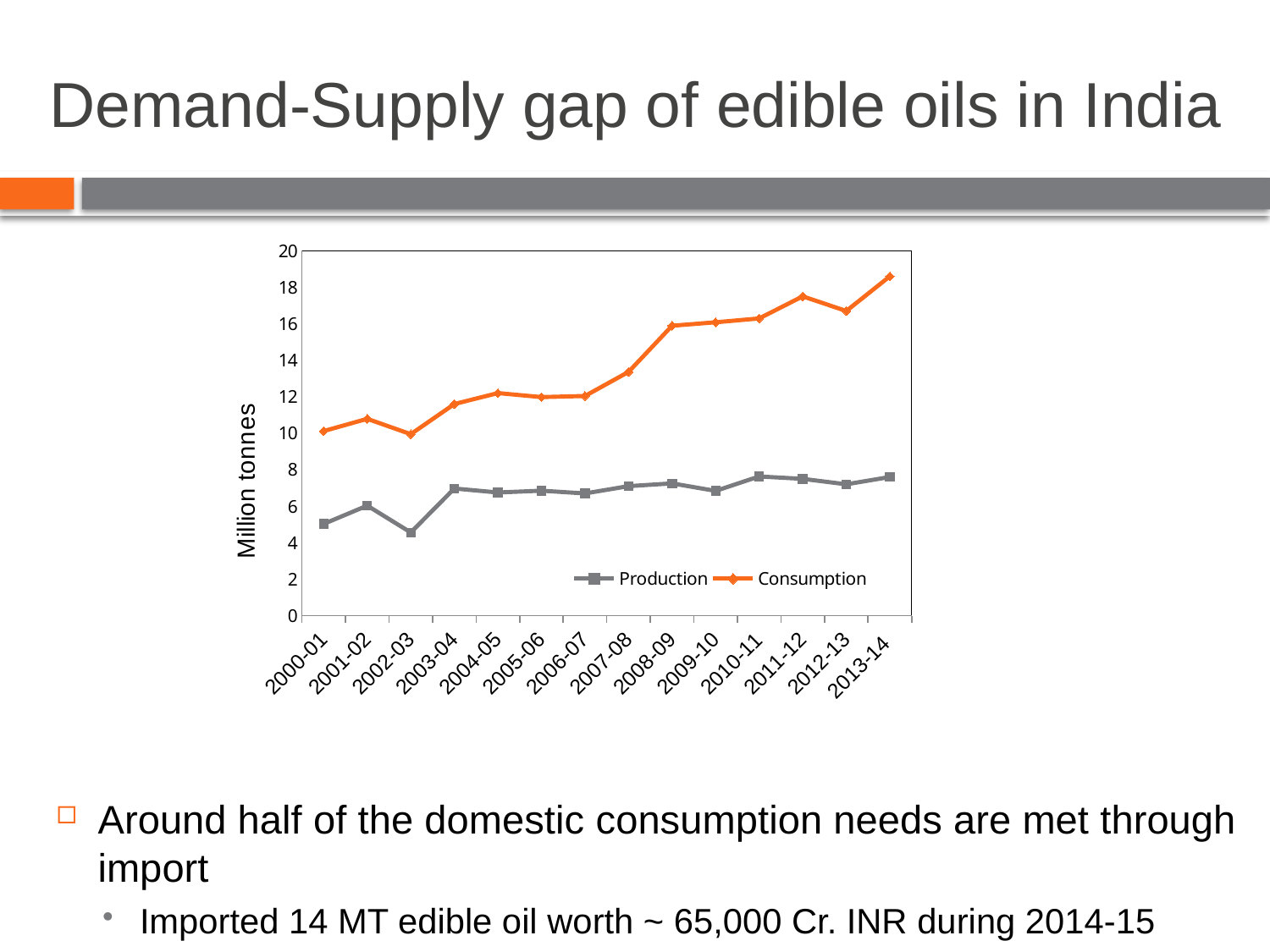
Which two series are listed in the legend? Production and Consumption In which year is Consumption highest? 2013-14 Is the Production value for 2002-03 greater or less than 6? less How many series does the legend list? 2 Is the Consumption value for 2011-12 greater or less than 16? greater Does Consumption generally rise or fall from 2000-01 to 2013-14? Rise What kind of chart is shown on the slide? Line chart What is the label on the y axis? Million tonnes Which is larger in 2013-14, Production or Consumption? Consumption How many years are plotted along the x axis? 14 In which year is Production lowest? 2002-03 Is the Consumption value for 2013-14 greater or less than 18? greater